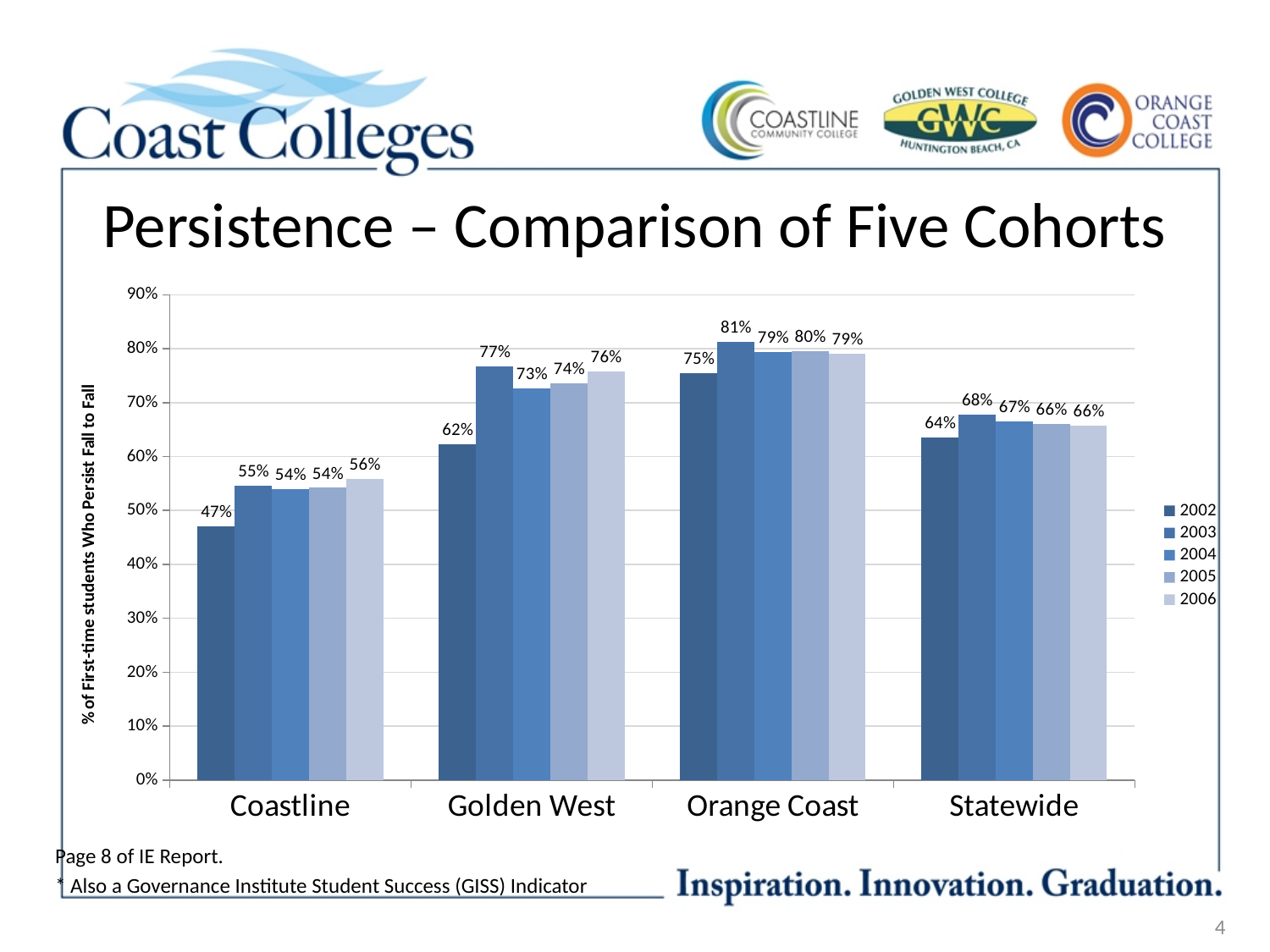
What kind of chart is shown on the slide? Bar chart Which college or group has the lowest persistence rate for the 2002 cohort? Coastline What is the Statewide persistence rate for the 2004 cohort? 67% What is the difference between the Golden West 2003 rate and the Golden West 2002 rate? 15% Which college or group has the highest persistence rate for the 2003 cohort? Orange Coast What is the persistence rate for Coastline in the 2002 cohort? 47% How many colleges or groups are shown on the x axis? 4 Which is larger: the Coastline 2006 rate or the Statewide 2006 rate? Statewide 2006 What is the title of the chart? Persistence – Comparison of Five Cohorts What is the persistence rate for Golden West in the 2006 cohort? 76% How many cohort years does the legend list? 5 What is the persistence rate for Orange Coast in the 2003 cohort? 81%